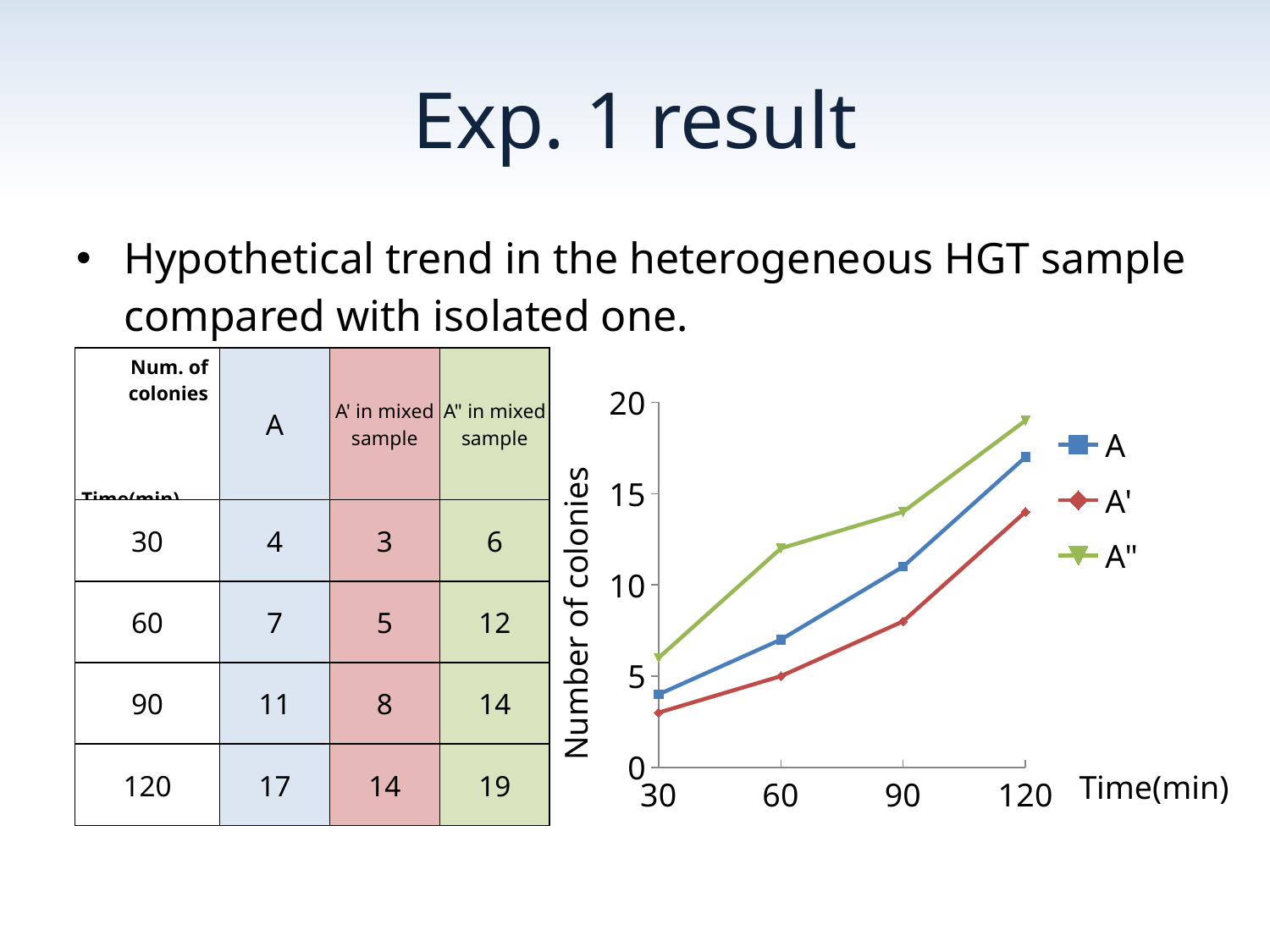
How many time points are plotted along the x axis of the chart? 4 Which series has the lowest number of colonies at 30 min? A' Which series has the highest number of colonies at 120 min? A'' What kind of chart is shown on the slide? line chart What is the number of colonies for series A at 120 min? 17 Do the values for series A rise or fall as time increases along the x axis? rise What is the number of colonies for series A' at 90 min? 8 What is the difference between the number of colonies for A'' and A' at 120 min? 5 At 60 min, which series has more colonies, A or A'? A What is the number of colonies for series A'' at 60 min? 12 What is the label of the y axis of the chart? Number of colonies How many series does the chart legend list? 3